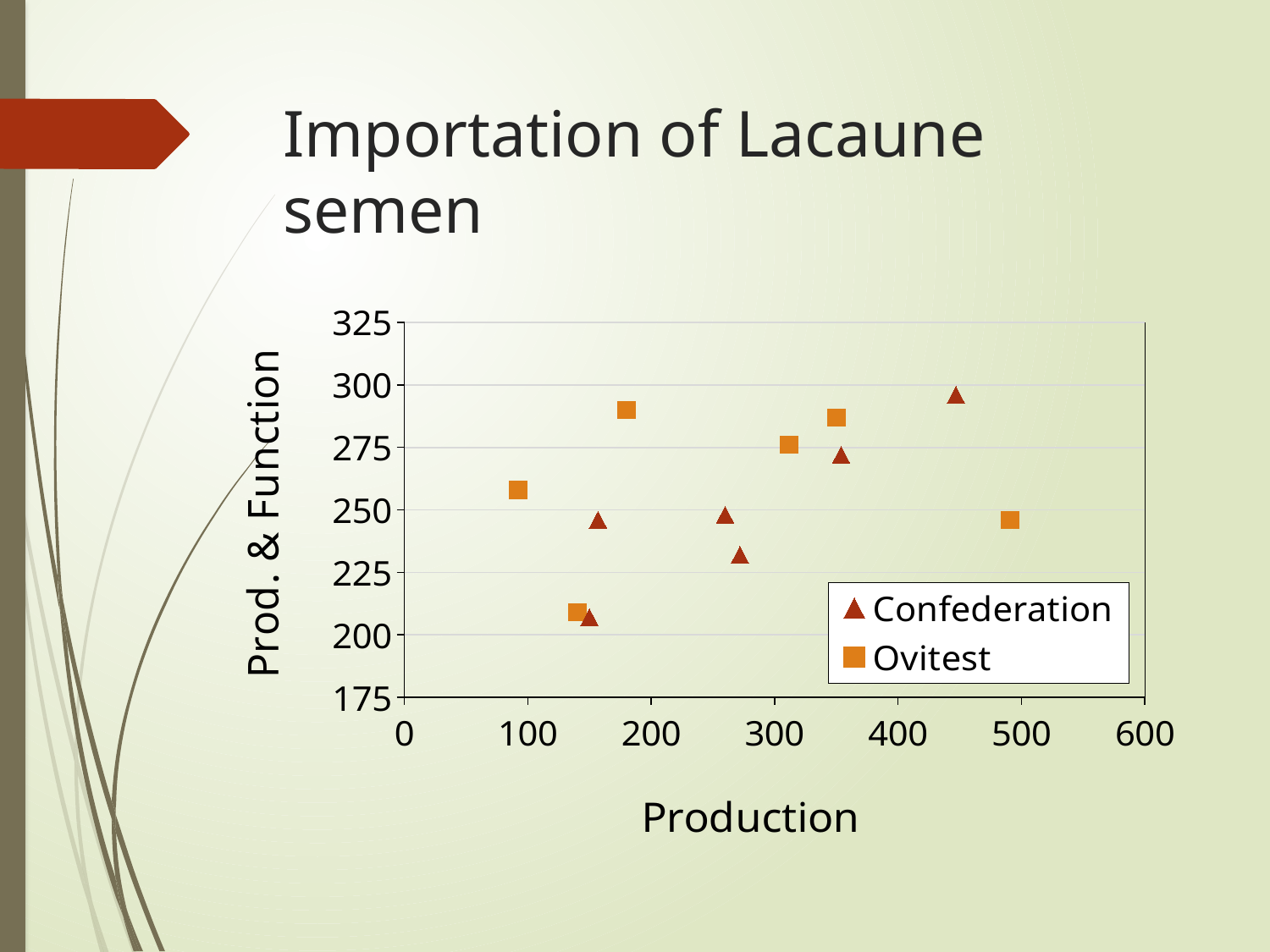
What is the title of the horizontal axis of the chart? Production What are the two series named in the chart legend? Confederation and Ovitest How many Ovitest points are plotted on the chart? 6 Is the Prod. & Function value of the lowest Confederation point greater or less than 225? less Is the Production value of the rightmost point on the chart greater or less than 400? greater Is the Production value of the leftmost Ovitest point greater or less than 200? less How many series does the chart legend list? 2 How many Confederation points are plotted on the chart? 6 What kind of chart is shown on the slide? scatter chart Which series does the point with the highest Production value belong to? Ovitest